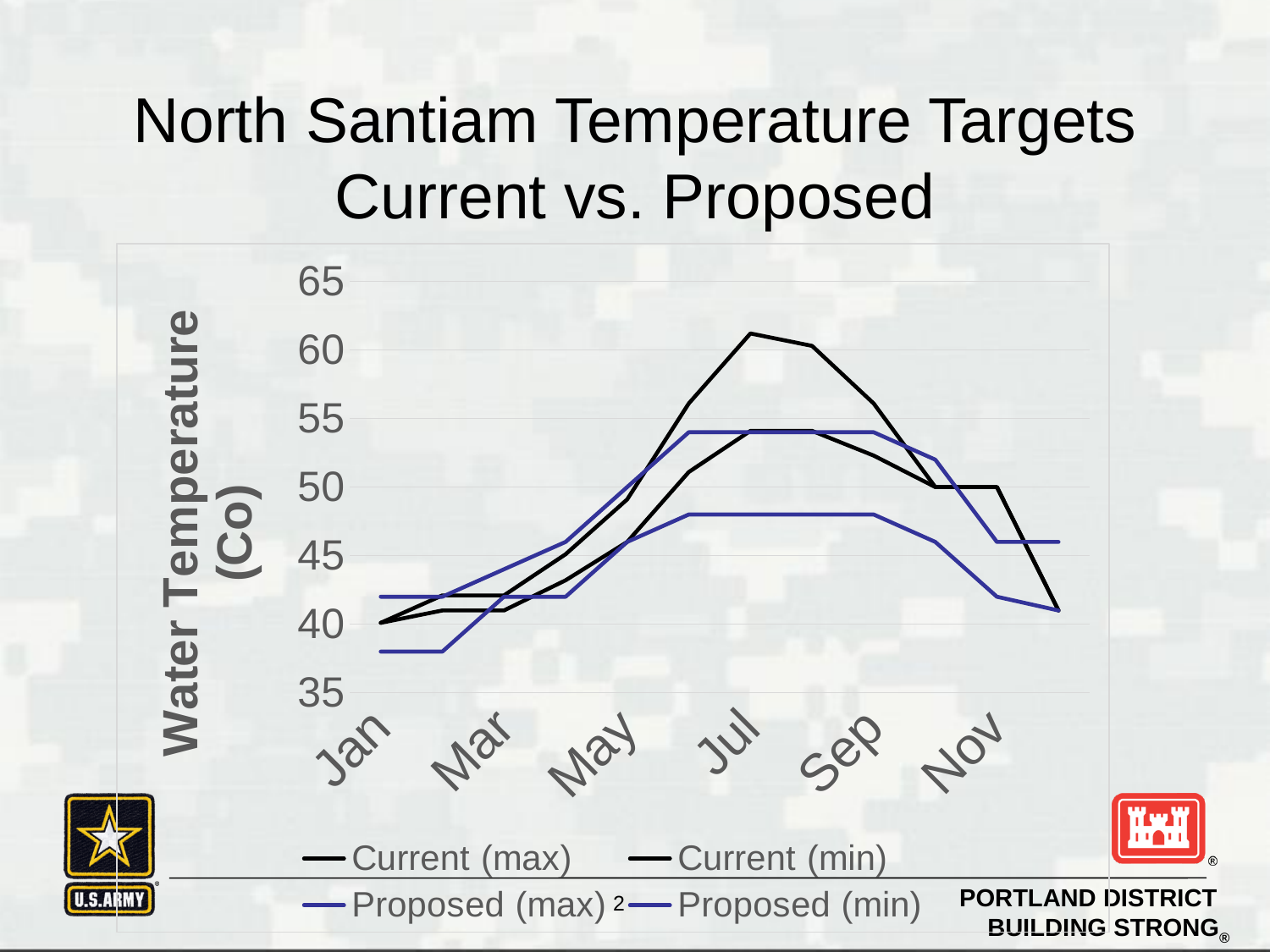
What type of chart is shown on the slide? line chart What is the label on the vertical axis? Water Temperature (Co) What is the title of the chart? North Santiam Temperature Targets Current vs. Proposed Which series has the lowest value in Jan? Proposed (min) Which series reaches the highest water temperature on the chart? Current (max) Is the value for Current (max) in Jul greater or less than 55? greater How many month labels are shown on the x axis? 6 How many series does the legend list? 4 In Jul, which is larger: Current (max) or Proposed (max)? Current (max) Is the value for Proposed (min) in Jan greater or less than 40? less Does the Current (max) line rise or fall from Jan to Jul? rise Is the value for Proposed (max) in Sep greater or less than 50? greater